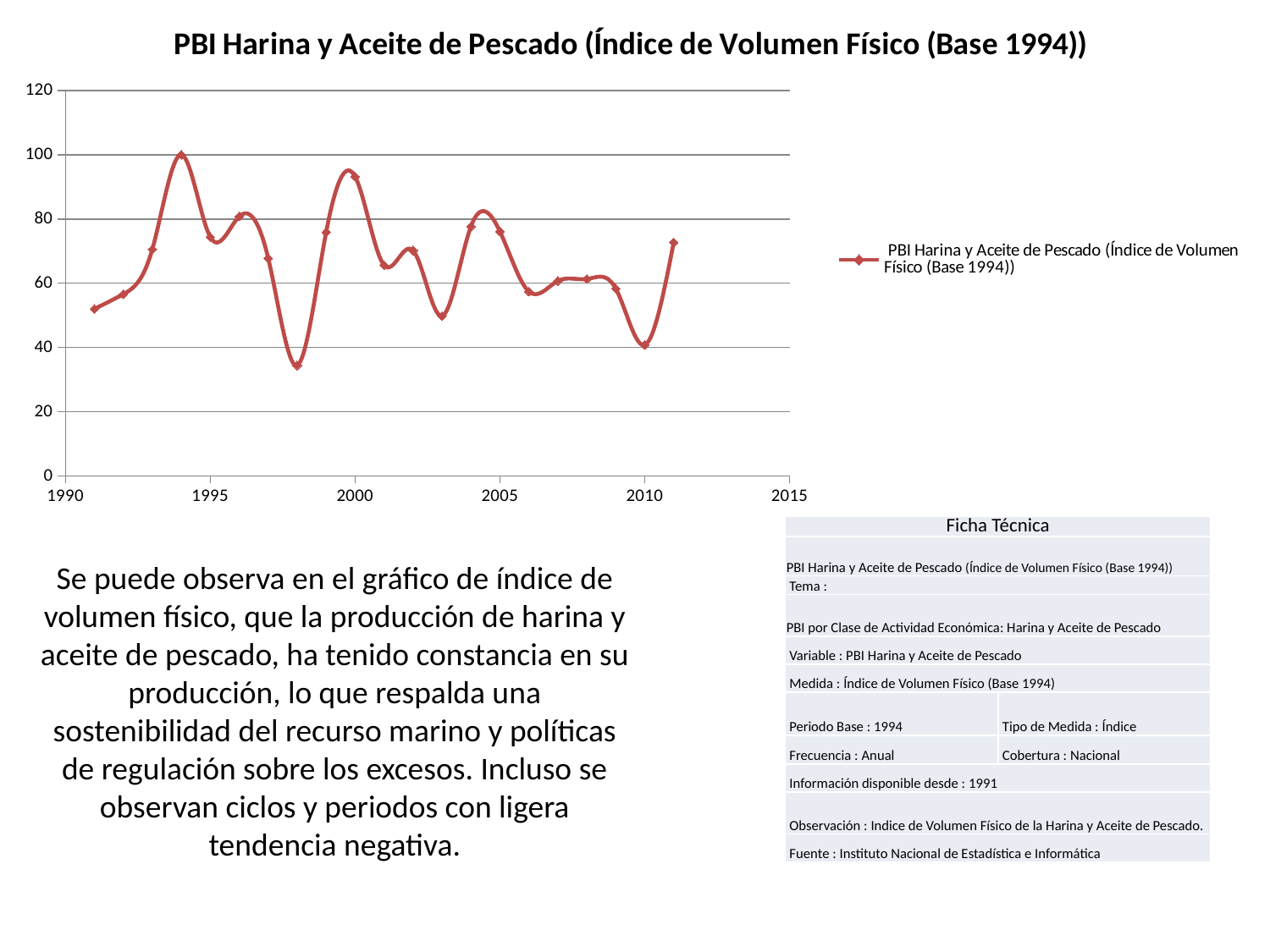
Is the value for 2000 greater or less than 80? greater Between 1994 and 1998, does the index rise or fall? fall What is the title of the chart? PBI Harina y Aceite de Pescado (Índice de Volumen Físico (Base 1994)) In which year does the index reach its lowest value? 1998 Is the value for 1998 greater or less than 40? less Which year has the larger value, 1994 or 2000? 1994 How many data points are plotted on the line? 21 In which year does the index reach its highest value? 1994 What is the value of the index in 1994? 100 What kind of chart is shown on the slide? line chart How many series does the legend list? 1 Is the value for 2010 greater or less than 60? less